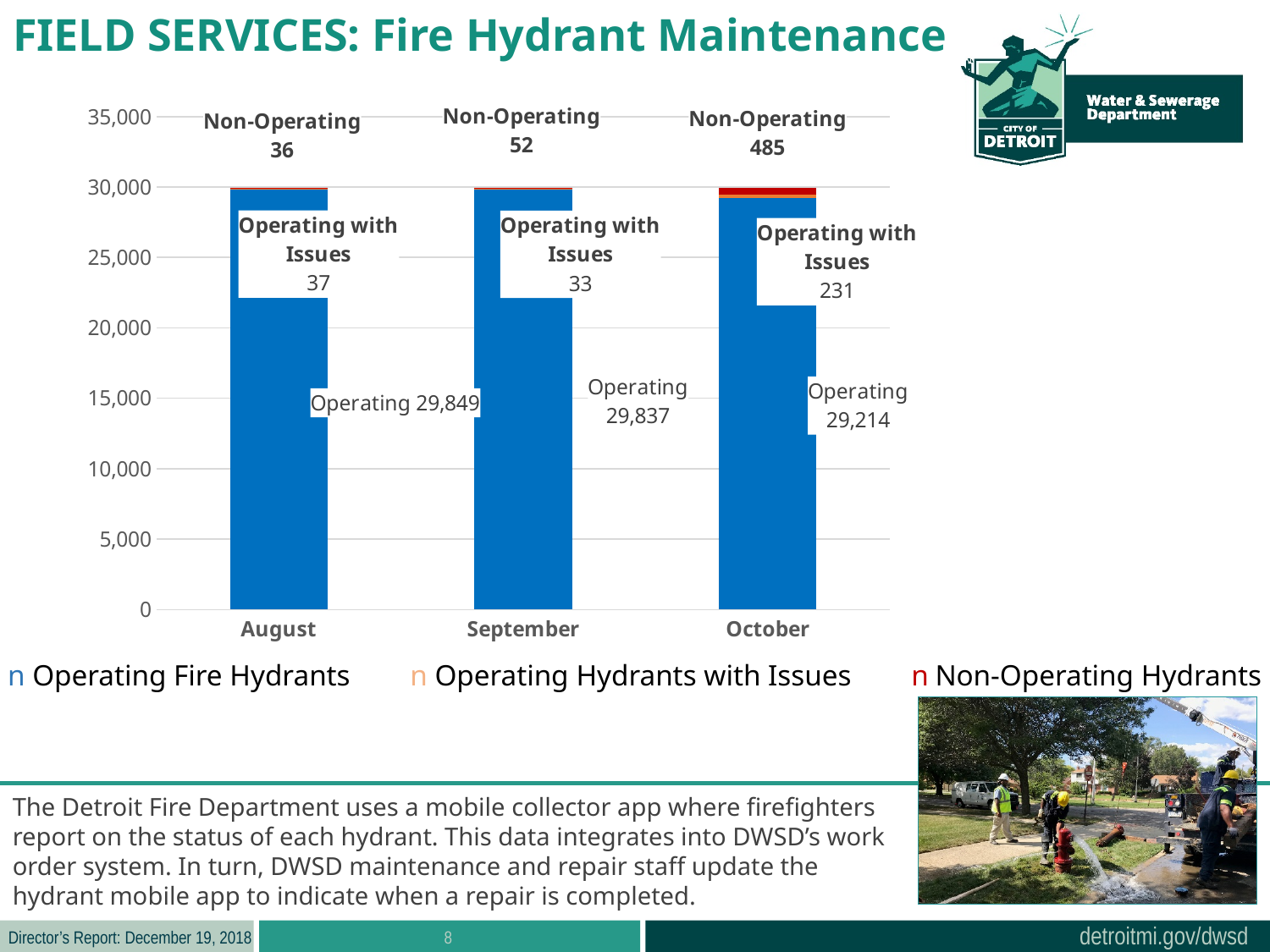
How many series does the chart legend list? 3 How many operating fire hydrants were there in August? 29,849 Which is larger: the number of operating hydrants with issues in October or the number of non-operating hydrants in October? Non-Operating hydrants in October What kind of chart is shown on the slide? Stacked bar chart What is the total number of hydrants in the October bar (operating, operating with issues, and non-operating combined)? 29,930 What is the difference between the number of operating fire hydrants in August and in October? 635 Is the number of operating fire hydrants in September greater or less than 25,000? greater Which month has the lowest number of operating fire hydrants? October How many months are shown on the x axis of the chart? 3 How many operating hydrants with issues were there in September? 33 What is the number of non-operating hydrants in October? 485 Which month has the highest number of non-operating hydrants? October